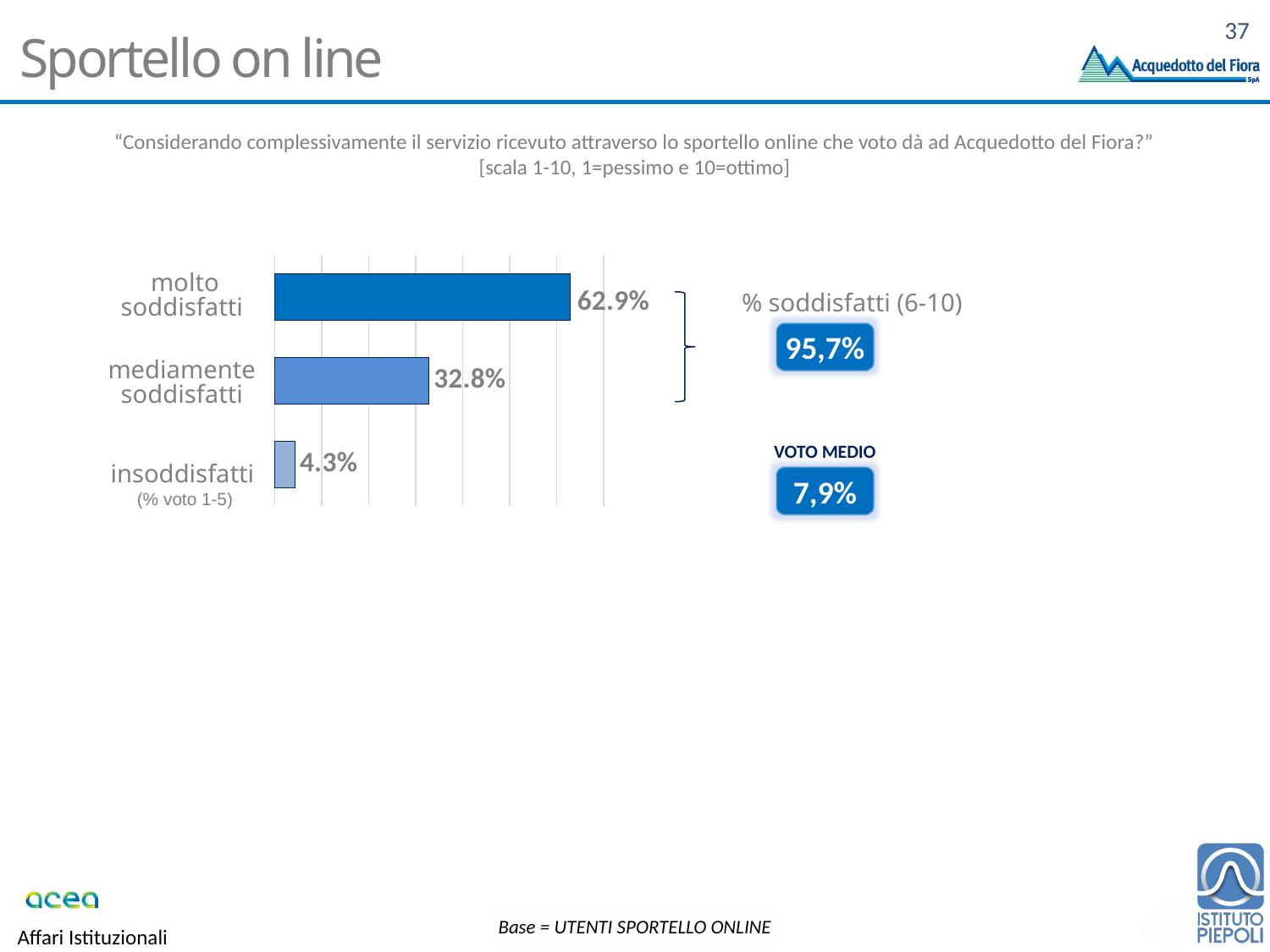
What is the value for "molto soddisfatti"? 62.9% What is the difference between the values for "mediamente soddisfatti" and "insoddisfatti"? 28.5% What is the difference between the values for "molto soddisfatti" and "mediamente soddisfatti"? 30.1% How many categories are shown in the chart? 3 What is the "% soddisfatti (6-10)" value shown next to the chart? 95,7% What is the value for "mediamente soddisfatti"? 32.8% What is the "VOTO MEDIO" value shown on the slide? 7,9% What kind of chart is shown on the slide? bar chart Which category has the lowest value? insoddisfatti What is the value for "insoddisfatti"? 4.3% Which is larger, the value for "mediamente soddisfatti" or the value for "insoddisfatti"? mediamente soddisfatti Which category has the highest value? molto soddisfatti